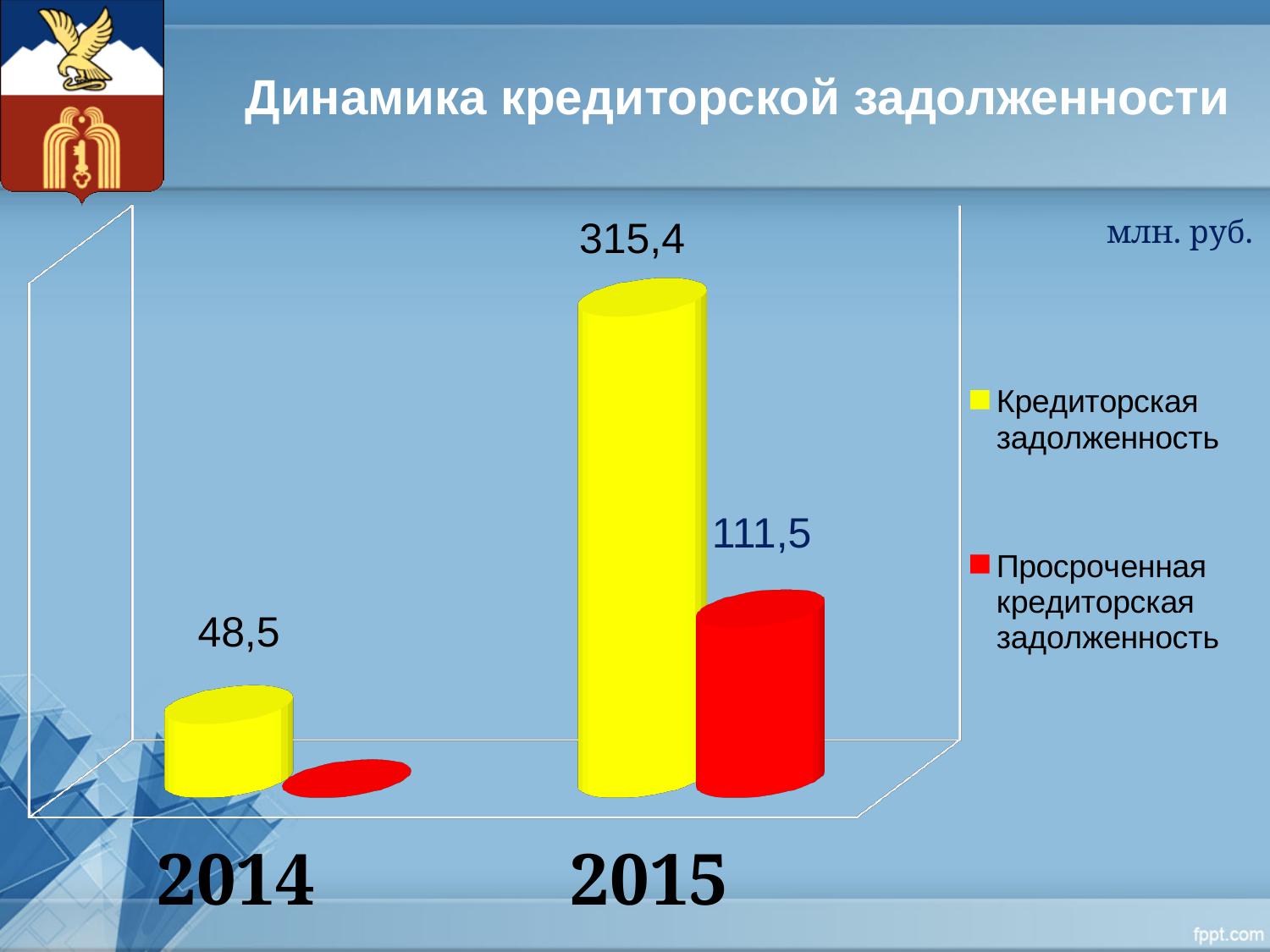
What kind of chart is shown on the slide? Bar chart How many series does the legend list? 2 What is the difference between Кредиторская задолженность and Просроченная кредиторская задолженность in 2015? 203,9 What is the value of Просроченная кредиторская задолженность for 2015? 111,5 How many years are shown on the x axis? 2 What is the value of Кредиторская задолженность for 2014? 48,5 Which year has the higher Кредиторская задолженность? 2015 By how much did Кредиторская задолженность increase from 2014 to 2015? 266,9 Which year has the lower Просроченная кредиторская задолженность? 2014 In 2015, which is larger: Кредиторская задолженность or Просроченная кредиторская задолженность? Кредиторская задолженность What is the value of Кредиторская задолженность for 2015? 315,4 Does Кредиторская задолженность rise or fall from 2014 to 2015? Rise